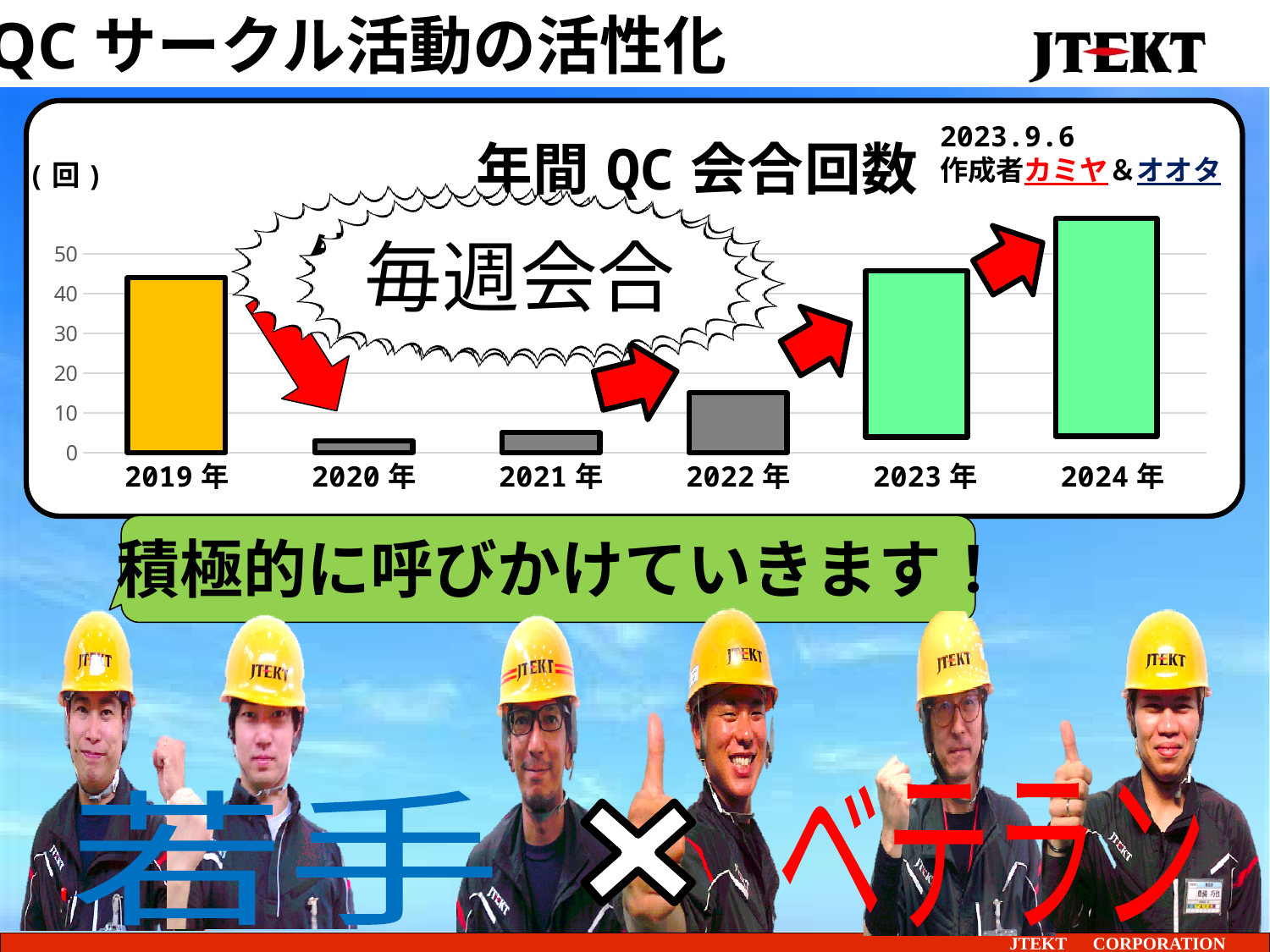
What is the title of the chart? 年間QC会合回数 How many years (categories) are shown on the x axis of the chart? 6 Is the value for 2022年 greater or less than 20? less Which is larger, the value for 2022年 or the value for 2023年? 2023年 Do the values rise or fall from 2020年 to 2024年? rise What kind of chart is shown on the slide? bar chart Is the value for 2019年 greater or less than 40? greater Which year has the highest number of QC meetings in the chart? 2024年 Is the value for 2024年 greater or less than 50? greater Which year has the lowest number of QC meetings in the chart? 2020年 What unit is shown on the y axis of the chart? 回